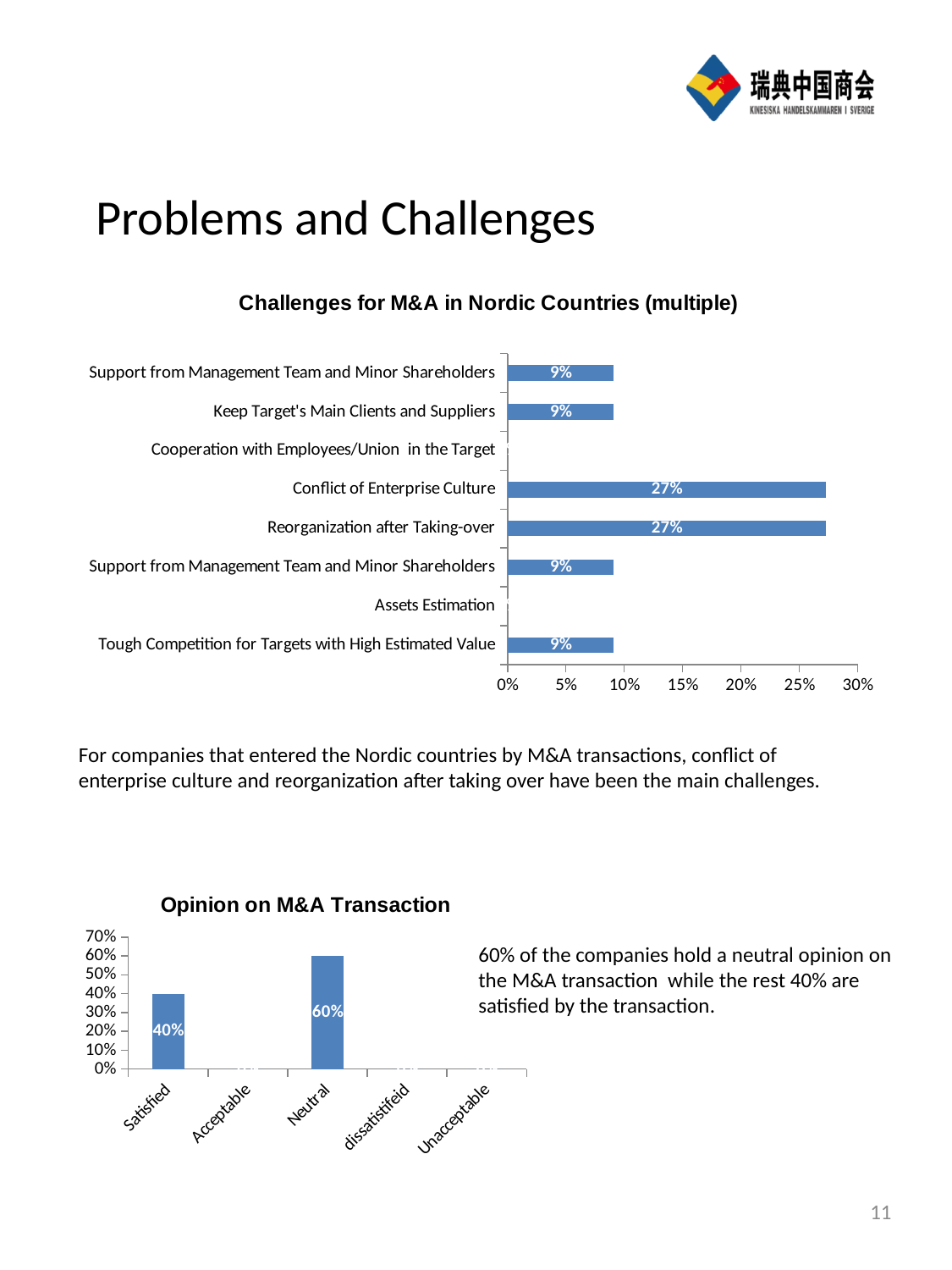
In the 'Opinion on M&A Transaction' chart, which category has the highest value? Neutral In the 'Challenges for M&A in Nordic Countries (multiple)' chart, what is the value for Reorganization after Taking-over? 27% How many categories are listed on the y axis of the 'Challenges for M&A in Nordic Countries (multiple)' chart? 8 What kind of chart is the 'Challenges for M&A in Nordic Countries (multiple)' chart? bar chart In the 'Opinion on M&A Transaction' chart, what is the value for Neutral? 60% In the 'Opinion on M&A Transaction' chart, what is the value for Satisfied? 40% In the 'Challenges for M&A in Nordic Countries (multiple)' chart, what is the difference between Conflict of Enterprise Culture and Tough Competition for Targets with High Estimated Value? 18% How many categories are shown on the x axis of the 'Opinion on M&A Transaction' chart? 5 In the 'Challenges for M&A in Nordic Countries (multiple)' chart, which is larger: Reorganization after Taking-over or Keep Target's Main Clients and Suppliers? Reorganization after Taking-over In the 'Challenges for M&A in Nordic Countries (multiple)' chart, what is the value for Keep Target's Main Clients and Suppliers? 9% In the 'Challenges for M&A in Nordic Countries (multiple)' chart, what is the value for Conflict of Enterprise Culture? 27% In the 'Challenges for M&A in Nordic Countries (multiple)' chart, is the value for Conflict of Enterprise Culture greater or less than 25%? greater